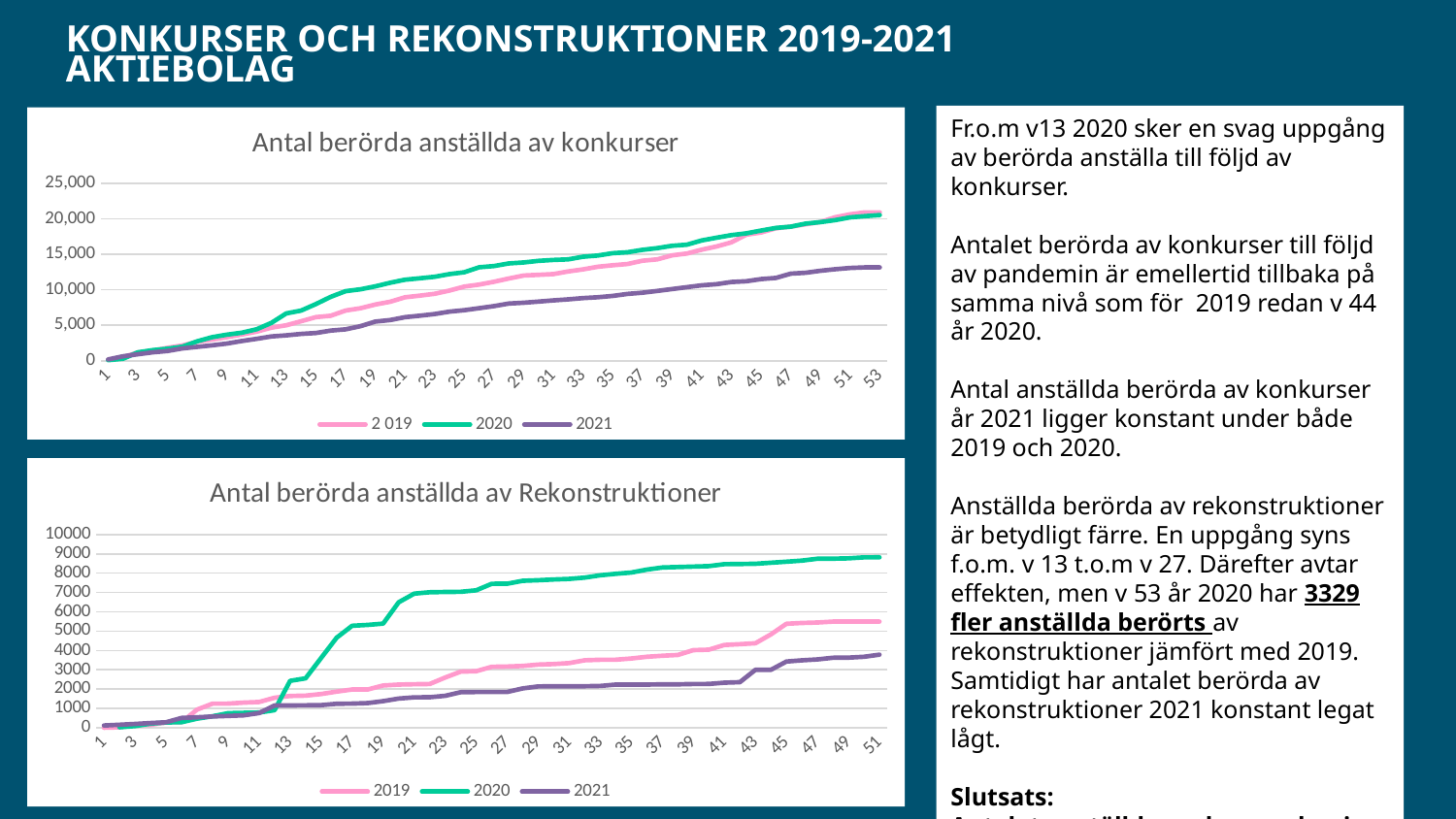
In "Antal berörda anställda av konkurser", is the value for 2021 at week 53 greater or less than 10,000? greater In "Antal berörda anställda av konkurser", is the value for 2020 at week 53 greater or less than 15,000? greater What kind of chart is "Antal berörda anställda av konkurser"? line chart In "Antal berörda anställda av Rekonstruktioner", which is larger at week 51: the value for 2019 or the value for 2021? 2019 In "Antal berörda anställda av konkurser", is the value for 2021 at week 53 greater or less than 15,000? less In "Antal berörda anställda av konkurser", which series has the lowest value at week 53? 2021 What is the title of the lower chart on the slide? Antal berörda anställda av Rekonstruktioner In "Antal berörda anställda av Rekonstruktioner", which series has the highest value at week 51? 2020 How many series does the legend of "Antal berörda anställda av Rekonstruktioner" list? 3 In "Antal berörda anställda av konkurser", do the values for 2020 rise or fall along the x axis? rise